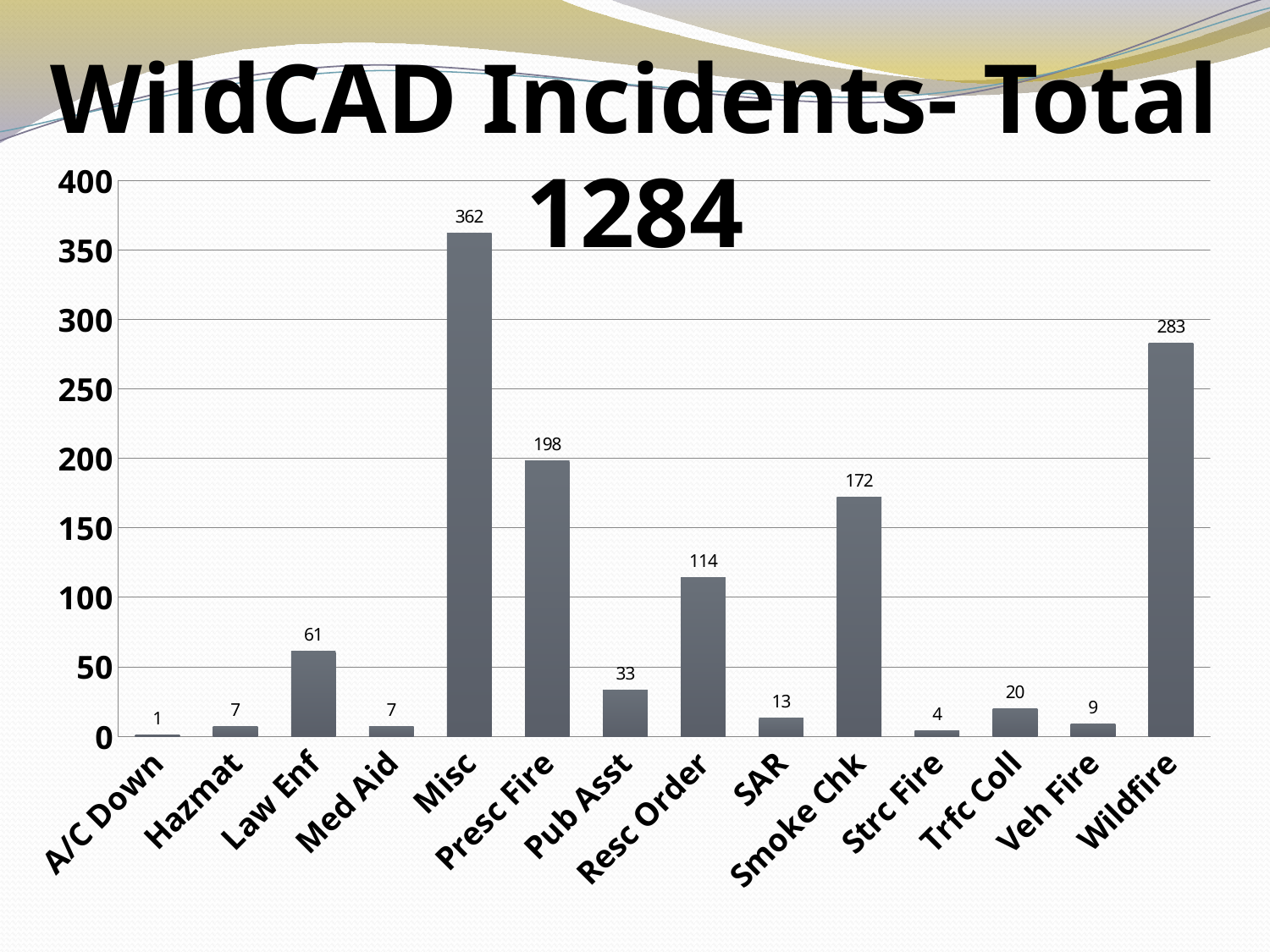
Which is larger, the value for Presc Fire or the value for Smoke Chk? Presc Fire What is the value for Misc? 362 Which category has the lowest value? A/C Down What is the value for Resc Order? 114 What is the difference between the values for Misc and Wildfire? 79 Is the value for Wildfire greater or less than 250? greater What kind of chart is shown on the slide? bar chart What is the value for Smoke Chk? 172 What is the title of the chart? WildCAD Incidents- Total 1284 How many categories are shown on the x axis? 14 What is the difference between the values for Law Enf and Pub Asst? 28 Which category has the highest value? Misc